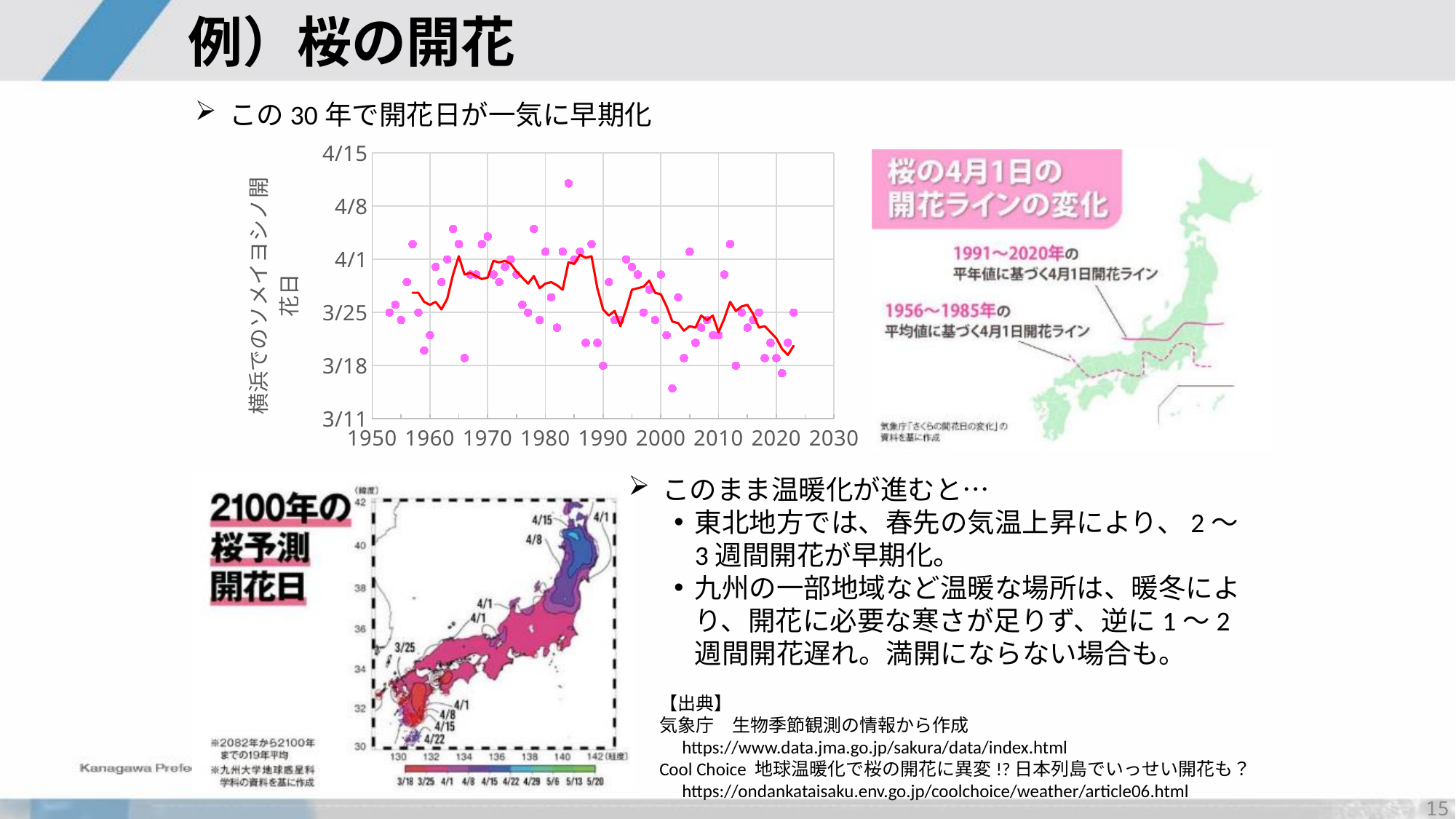
In the scatter chart, which decade has the highest plotted point: the 1980s or the 2010s? 1980s What kind of chart is shown on the left of the slide (the one with years on the x axis)? scatter chart with a trend line What is the first year tick shown on the x axis of the scatter chart? 1950 In the scatter chart, is the red trend line around 2020 earlier or later than 4/1? earlier What is the highest tick shown on the y axis of the scatter chart? 4/15 What is the lowest tick shown on the y axis of the scatter chart? 3/11 What is the last year tick shown on the x axis of the scatter chart? 2030 In the scatter chart, is the red trend line around 1965 later or earlier than 3/25? later What is the label on the y axis of the scatter chart? 横浜でのソメイヨシノ開花日 In the scatter chart, is the highest plotted point (around 1983) later or earlier than 4/8? later In the chart of Yokohama cherry blossom flowering dates, do the values generally rise or fall as the years go from 1950 to 2030? fall